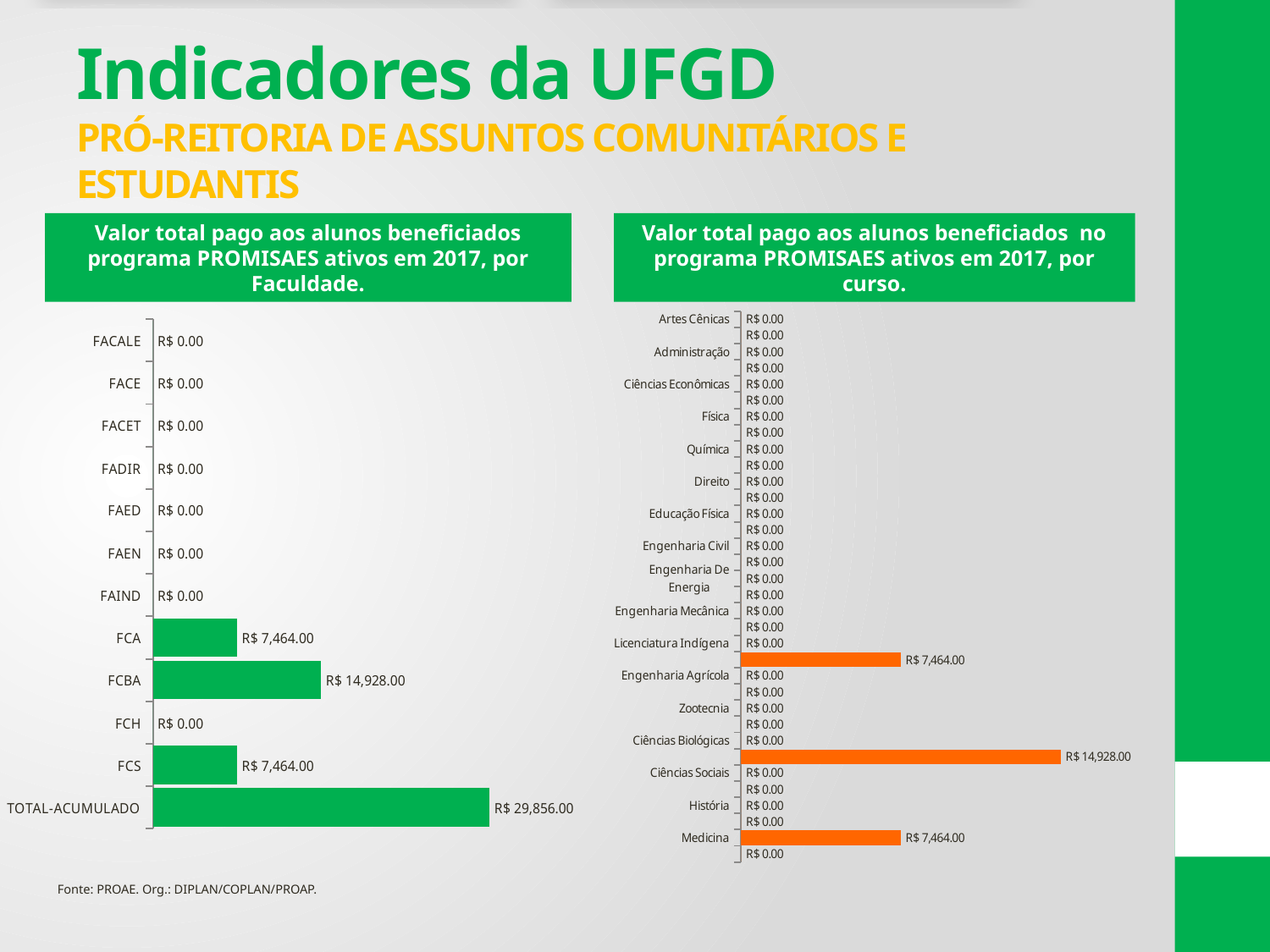
On the left chart (por Faculdade), what is the difference between the values for FCBA and FCS? R$ 7,464.00 On the left chart (por Faculdade), what is the value for FCA? R$ 7,464.00 On the right chart (por curso), what is the value for Medicina? R$ 7,464.00 On the left chart (por Faculdade), which is larger, the value for FCBA or the value for FCA? FCBA On the left chart (por Faculdade), which faculty (excluding TOTAL-ACUMULADO) has the highest value? FCBA On the left chart (por Faculdade), what is the value for FCH? R$ 0.00 On the left chart (por Faculdade), what is the value for FCBA? R$ 14,928.00 On the right chart (por curso), what is the value for Direito? R$ 0.00 What colour are the bars on the right chart (por curso)? Orange On the left chart (por Faculdade), how many categories are shown, including TOTAL-ACUMULADO? 12 What type of chart is the left chart (por Faculdade)? Bar chart On the left chart (por Faculdade), what is the value for TOTAL-ACUMULADO? R$ 29,856.00